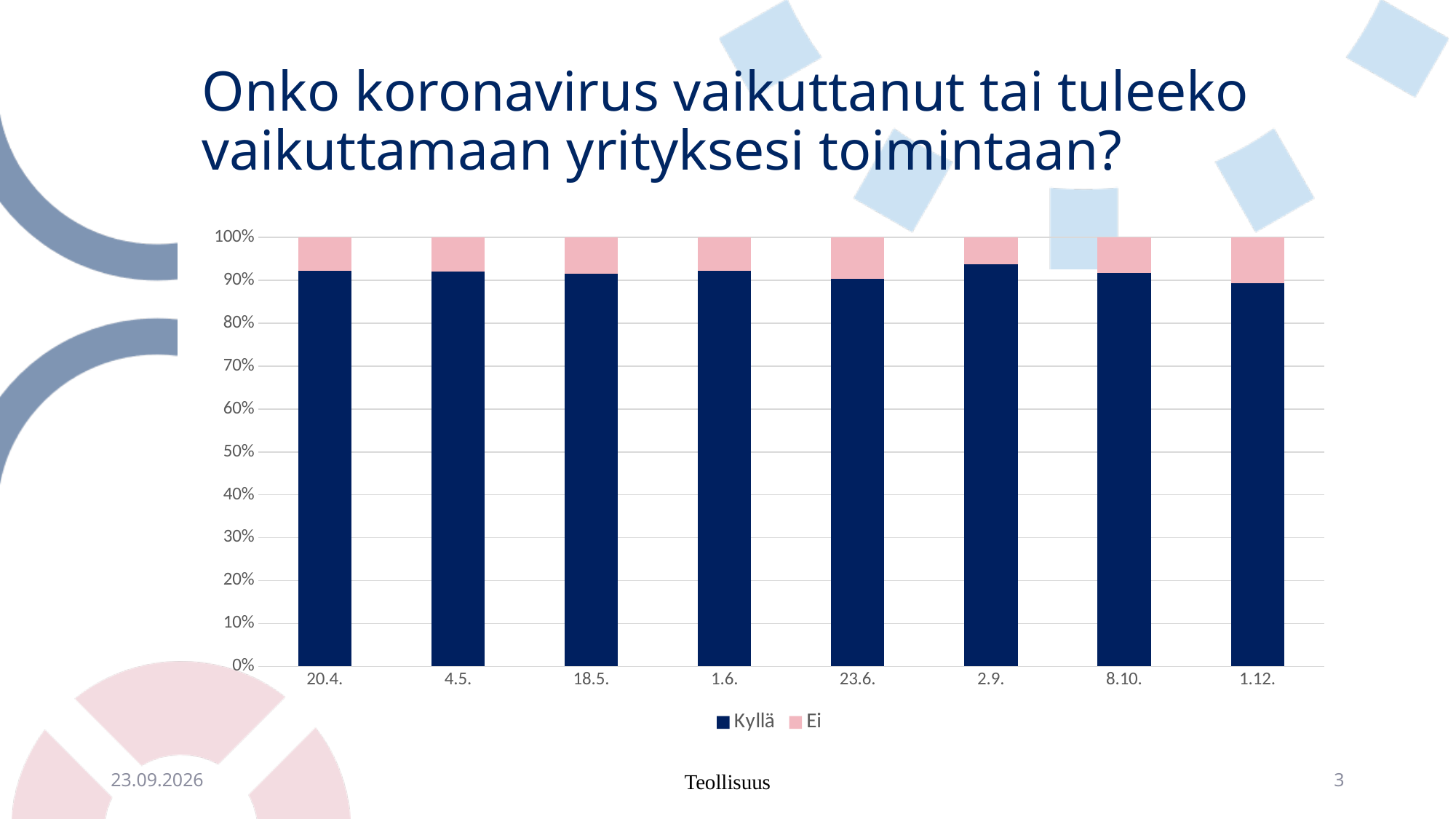
Which date has the highest Kyllä share? 2.9. What kind of chart is shown on the slide? Stacked bar chart How many series does the legend list? 2 What is the total of each stacked bar? 100% Is the Kyllä value for 20.4. greater or less than 80%? greater Is the Kyllä value for 4.5. greater or less than 50%? greater Is the Ei value for 1.12. greater or less than 20%? less How many dates (categories) are shown on the x axis? 8 Which is larger, the Kyllä share for 2.9. or for 1.12.? 2.9. What are the two series named in the legend? Kyllä and Ei Which colour represents the Kyllä series? Dark blue